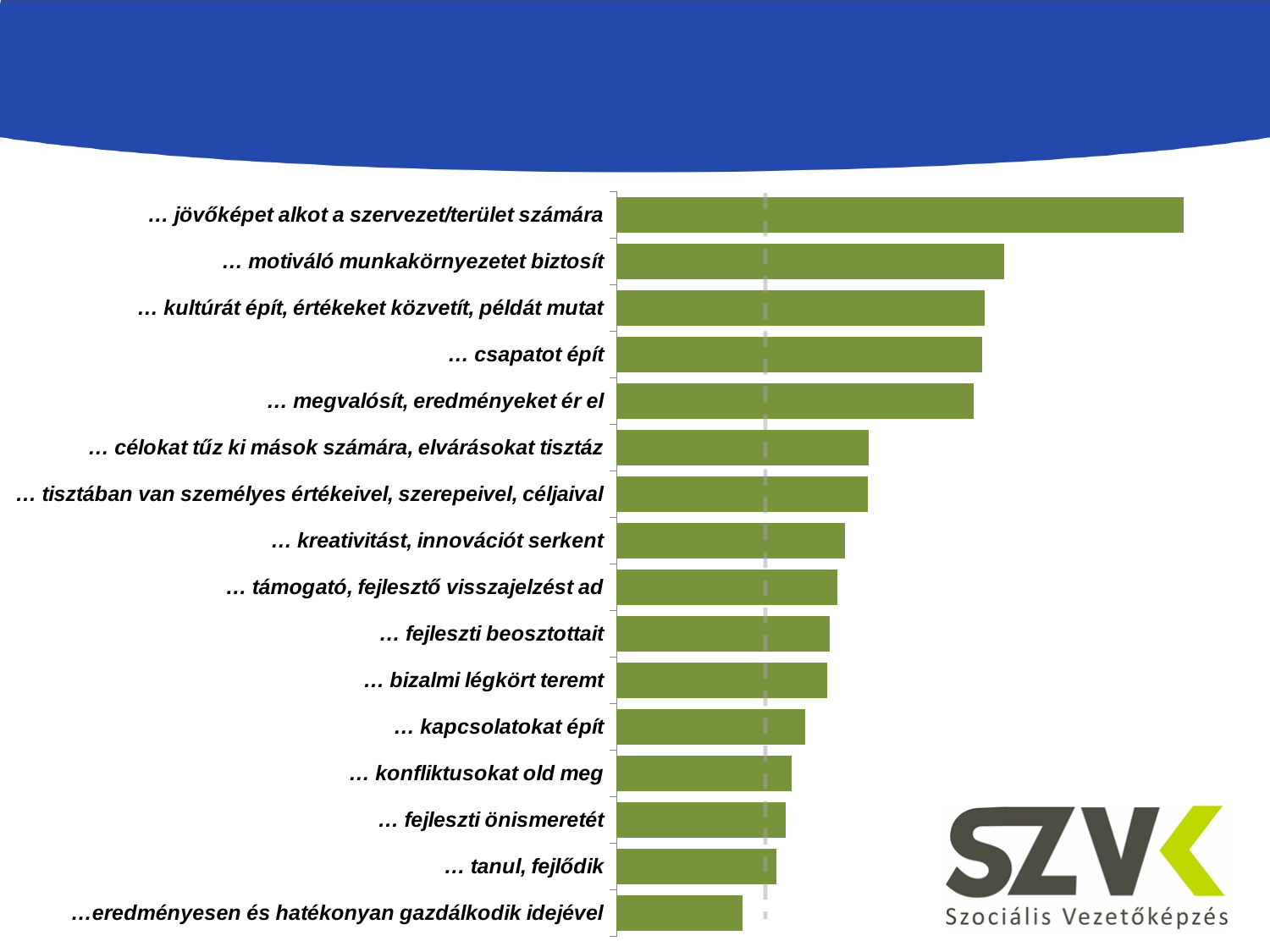
Which bar is longer: '… megvalósít, eredményeket ér el' or '… célokat tűz ki mások számára, elvárásokat tisztáz'? … megvalósít, eredményeket ér el Does the bar for '…eredményesen és hatékonyan gazdálkodik idejével' end to the left or to the right of the dashed vertical line? left Which bar is longer: '… tanul, fejlődik' or '… kreativitást, innovációt serkent'? … kreativitást, innovációt serkent Which bar is longer: '… jövőképet alkot a szervezet/terület számára' or '… motiváló munkakörnyezetet biztosít'? … jövőképet alkot a szervezet/terület számára Which category has the longest bar? … jövőképet alkot a szervezet/terület számára What kind of chart is shown on the slide? bar chart How many categories (bars) does the chart show? 16 What colour are the bars in the chart? green Going from the top of the chart to the bottom, do the bars get longer or shorter? shorter Which category has the shortest bar? …eredményesen és hatékonyan gazdálkodik idejével